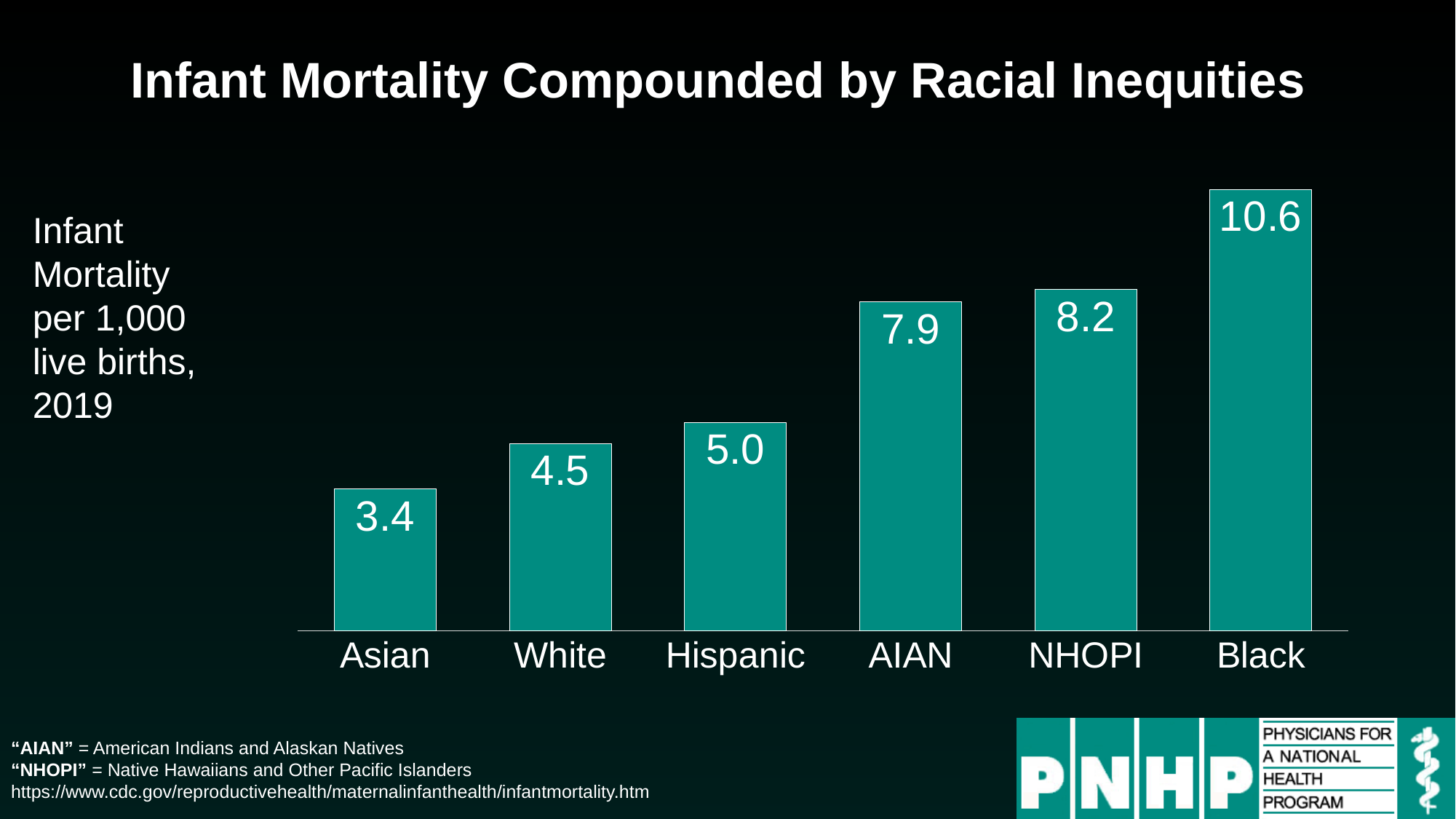
What is the infant mortality rate per 1,000 live births for AIAN infants? 7.9 What type of chart is shown on the slide? Bar chart Do the infant mortality values rise or fall from left to right across the groups? Rise What is the infant mortality rate per 1,000 live births for Asian infants? 3.4 How many racial/ethnic groups are shown in the chart? 6 What is the difference between the infant mortality rates for Black and White infants? 6.1 Which group has the highest infant mortality rate? Black What is the difference between the infant mortality rates for NHOPI and Hispanic infants? 3.2 What is the infant mortality rate per 1,000 live births for Black infants? 10.6 Which group has the lowest infant mortality rate? Asian Which group has a higher infant mortality rate, White or Hispanic? Hispanic What is the infant mortality rate per 1,000 live births for Hispanic infants? 5.0